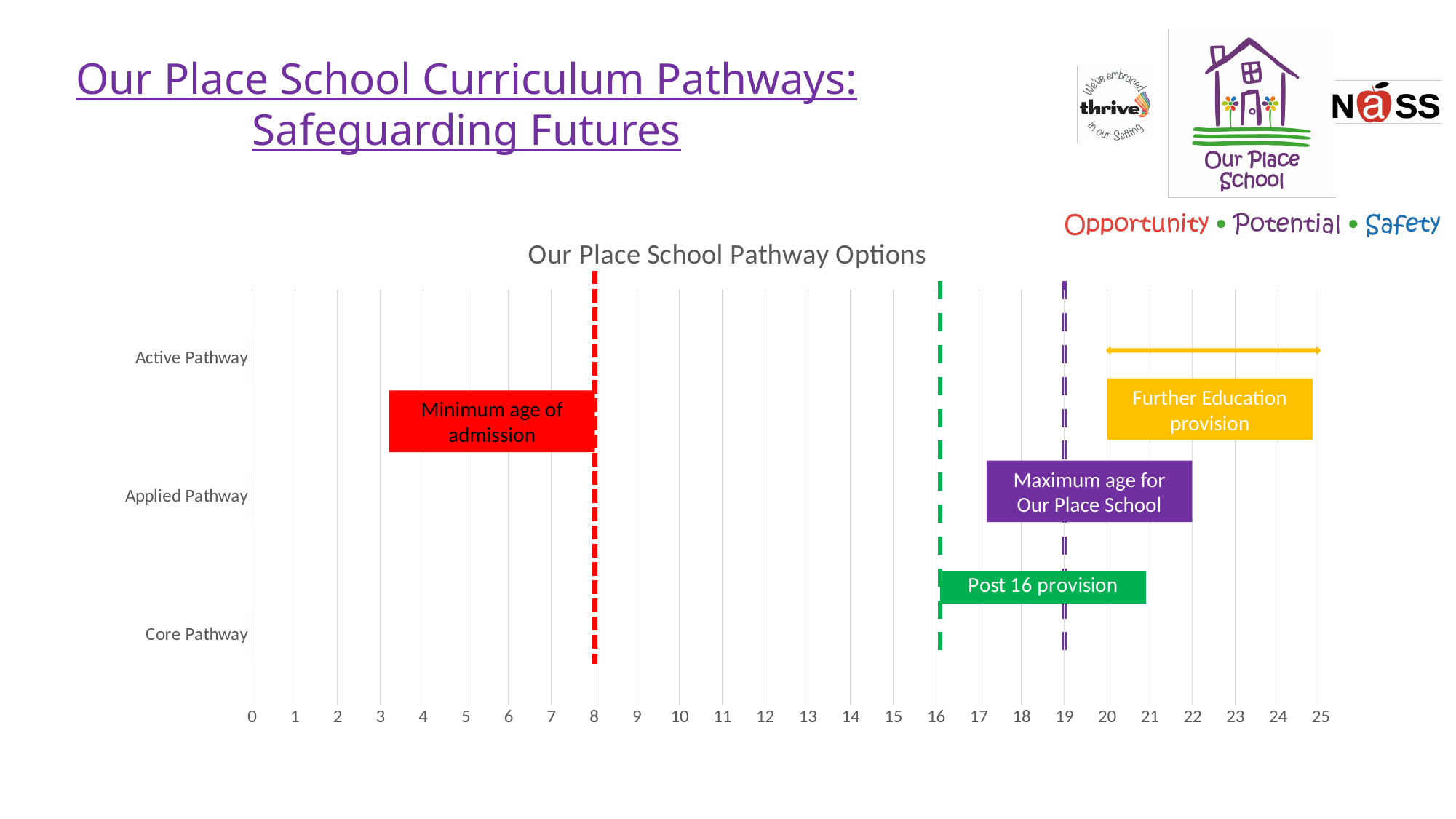
Is the purple dashed line for the maximum age for Our Place School greater or less than 15 on the x axis? greater Which is larger on the chart: the age marked by the green dashed line (Post 16 provision) or the age marked by the purple dashed line (Maximum age for Our Place School)? Maximum age for Our Place School What kind of chart is shown on the slide? bar chart Is the red dashed line for the minimum age of admission greater or less than 10 on the x axis? less At which age on the x axis is the purple dashed line labelled 'Maximum age for Our Place School' drawn? 19 How many pathway categories are listed on the vertical axis of the chart? 3 What is the difference in years between the maximum age for Our Place School (19) and the minimum age of admission (8) marked on the chart? 11 At which age on the x axis is the red dashed line labelled 'Minimum age of admission' drawn? 8 What is the title of the chart on the slide? Our Place School Pathway Options At which age on the x axis does the green dashed line for 'Post 16 provision' appear? 16 What is the highest value shown on the chart's x axis? 25 Which category is listed at the top of the chart's vertical axis? Active Pathway